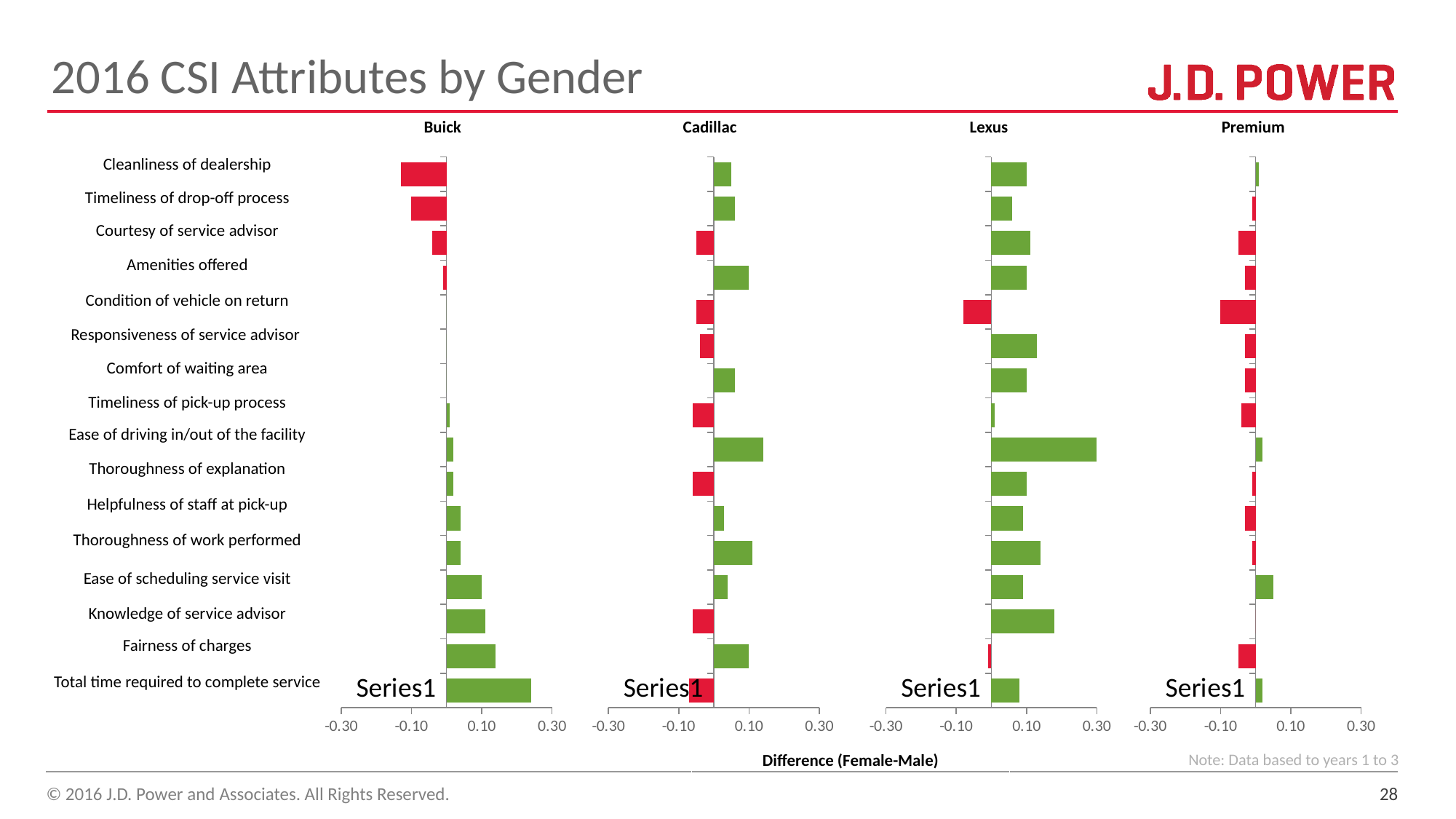
In the Buick chart, is the value for Total time required to complete service greater or less than 0.10? greater In the Lexus chart, which attribute has the highest value? Ease of driving in/out of the facility What is the x-axis title shown beneath the charts? Difference (Female-Male) In the Buick chart, which attribute has the lowest value? Cleanliness of dealership In the Premium chart, which attribute has the lowest value? Condition of vehicle on return In the Buick chart, which attribute has the highest value? Total time required to complete service How many attribute categories are listed on the slide's charts? 16 In the Cadillac chart, which attribute has the highest value? Ease of driving in/out of the facility What kind of chart is used for the Buick panel? bar chart In the Lexus chart, which attribute has the lowest value? Condition of vehicle on return In the Buick chart, which is larger: Fairness of charges or Knowledge of service advisor? Fairness of charges In the Lexus chart, is the value for Ease of driving in/out of the facility greater or less than 0.10? greater